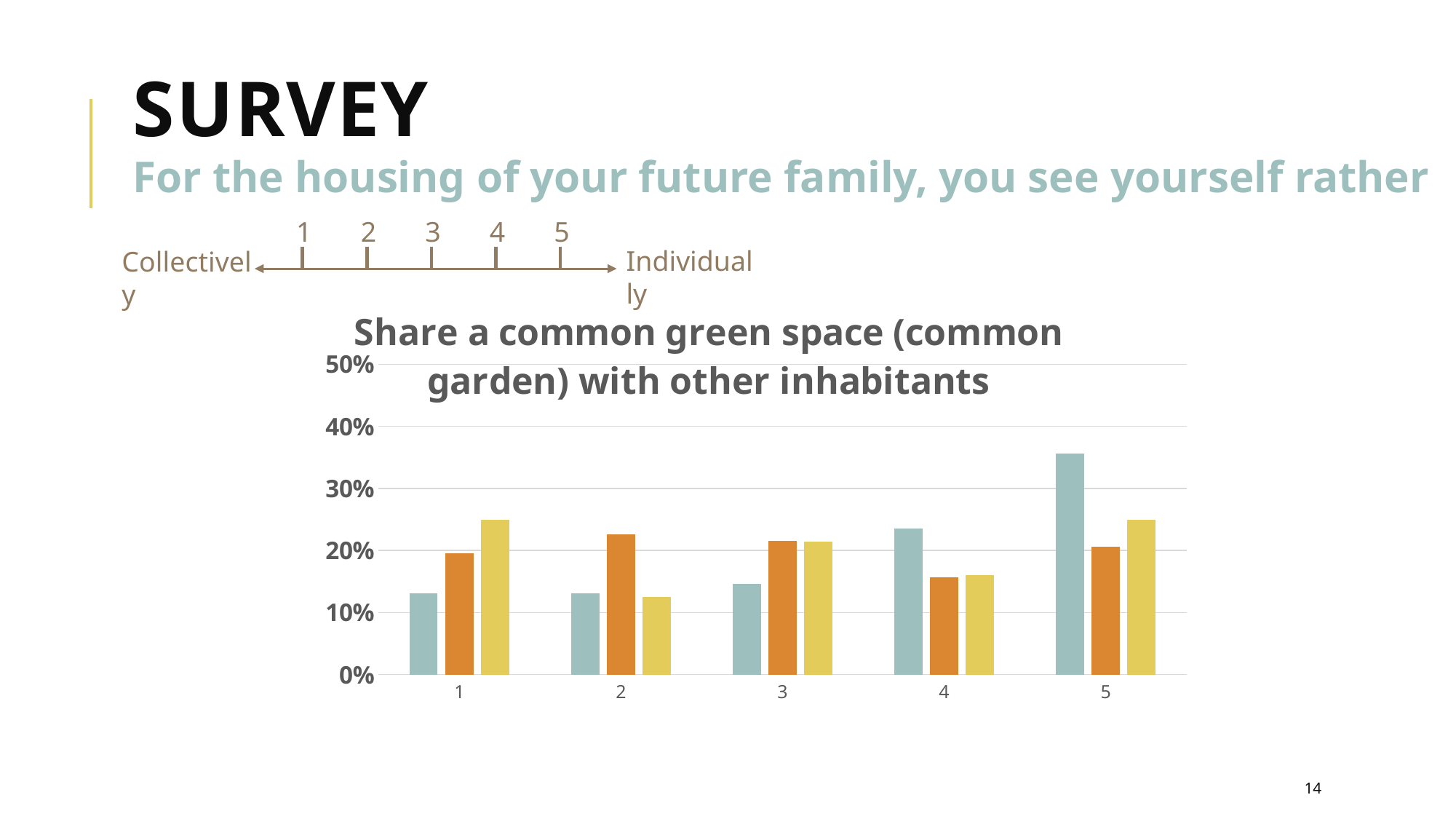
How many categories are shown on the x axis of the chart? 5 Which category contains the tallest bar on the chart? 5 What kind of chart is shown on the slide? bar chart How many bars are plotted for each category on the chart? 3 Is the value of the orange bar for category 2 greater or less than 20%? greater Is the value of the teal bar for category 5 greater or less than 30%? greater Is the value of the teal bar for category 1 greater or less than 20%? less For category 4, which is larger: the teal bar or the orange bar? the teal bar What is the highest value shown on the y axis of the chart? 50% For category 1, which is larger: the teal bar or the yellow bar? the yellow bar What is the title of the chart? Share a common green space (common garden) with other inhabitants